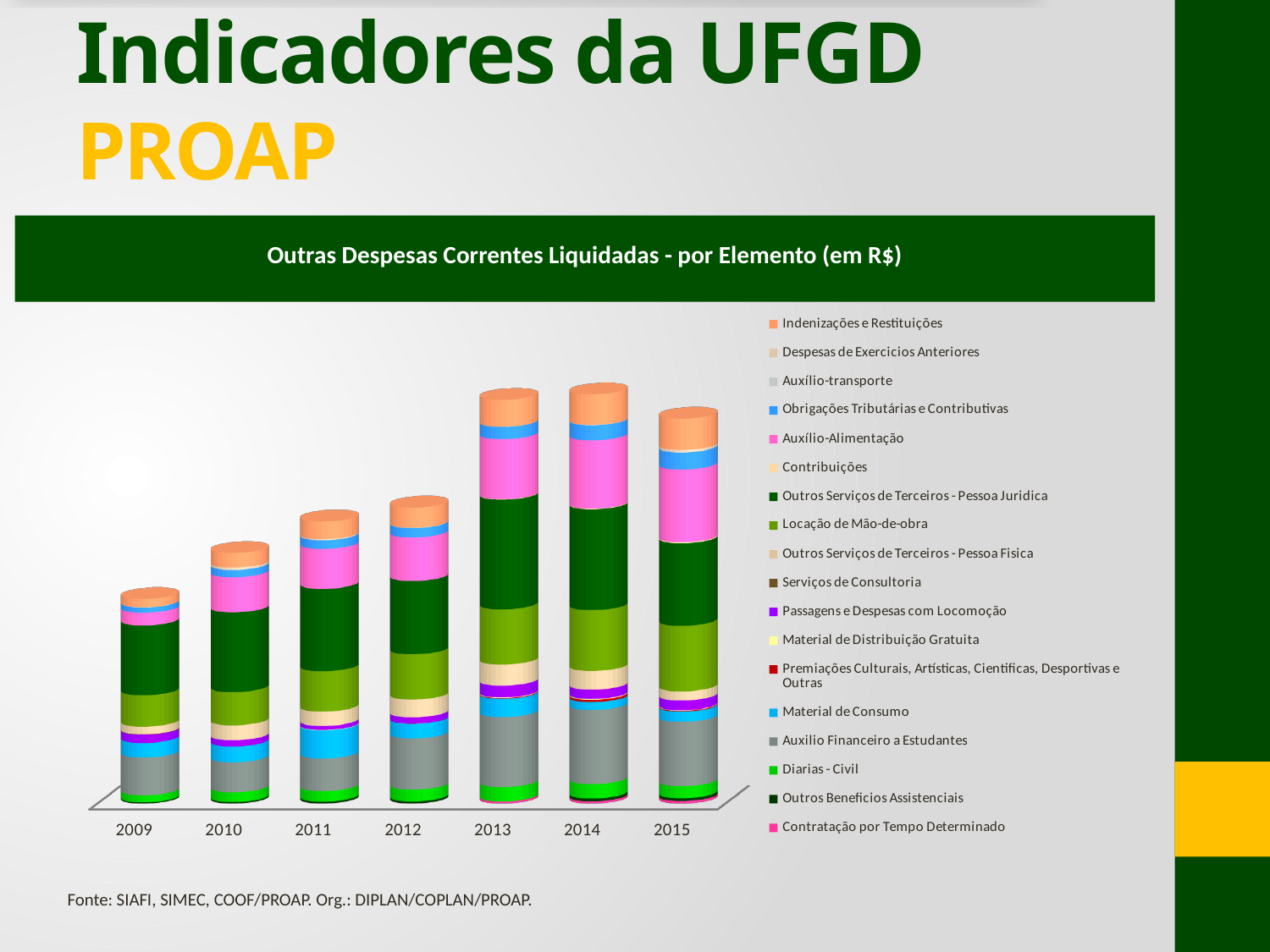
Do the total bars rise or fall from 2009 to 2013? Rise What kind of chart is shown on the slide? Stacked bar chart Does the total bar rise or fall from 2014 to 2015? Fall Which year has the larger total bar, 2012 or 2013? 2013 What is the first year shown on the x axis of the chart? 2009 How many years are shown along the x axis of the chart? 7 What is the title of the chart? Outras Despesas Correntes Liquidadas - por Elemento (em R$) Which year has the lowest total bar in the chart? 2009 Which year has the larger total bar, 2009 or 2015? 2015 Which year has the larger total bar, 2010 or 2011? 2011 How many series does the chart legend list? 18